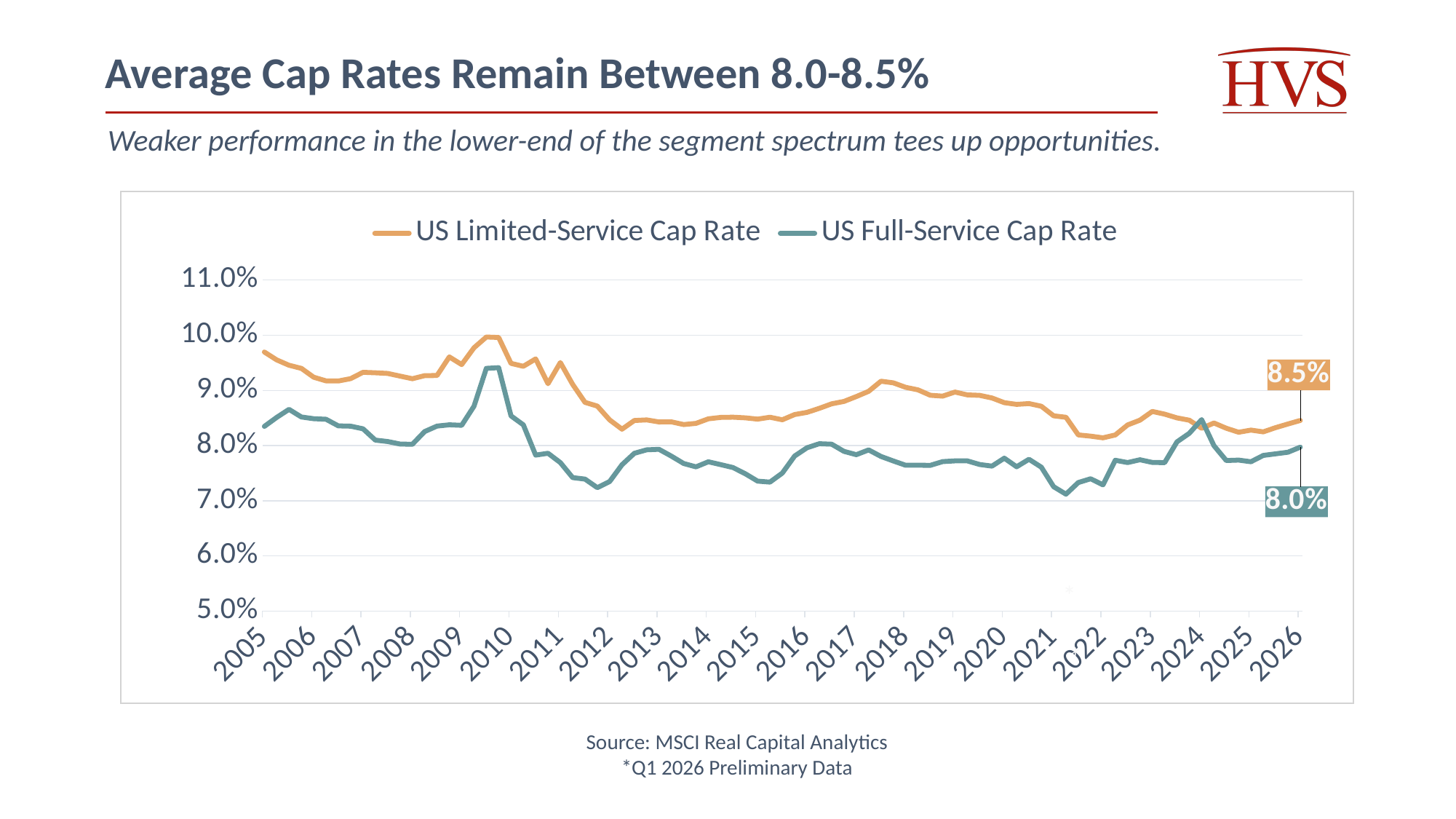
Is the peak of the US Limited-Service Cap Rate around 2010 greater or less than 9.5%? greater Is the lowest point of the US Full-Service Cap Rate around 2021 greater or less than 7.5%? less What kind of chart is shown on the slide? line chart Is the US Limited-Service Cap Rate in 2005 greater or less than 9.0%? greater What is the labelled value of the US Full-Service Cap Rate at the end of the series in 2026? 8.0% Which series has the higher value at the end of the chart in 2026, US Limited-Service Cap Rate or US Full-Service Cap Rate? US Limited-Service Cap Rate Does the US Limited-Service Cap Rate rise or fall overall from 2005 to 2026? fall What is the labelled value of the US Limited-Service Cap Rate at the end of the series in 2026? 8.5% What colour is the line for the US Limited-Service Cap Rate? orange How many series does the legend list? 2 What is the difference between the labelled 2026 values of the US Limited-Service Cap Rate and the US Full-Service Cap Rate? 0.5%